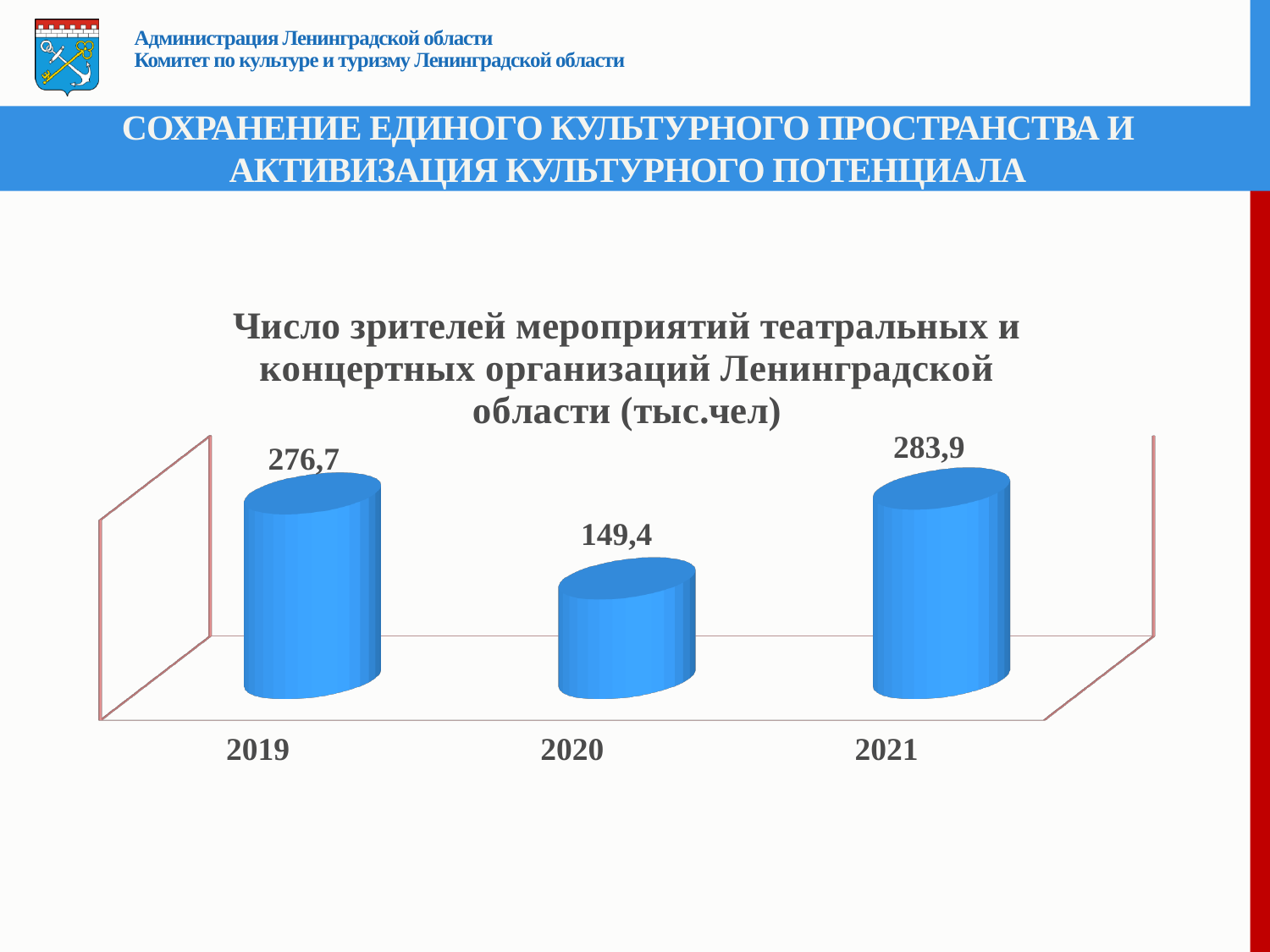
In what unit are the values on the chart expressed, according to the title? тыс.чел What is the difference between the values for 2021 and 2020? 134,5 What is the value for 2021? 283,9 What is the difference between the values for 2019 and 2020? 127,3 Which year has the highest number of spectators? 2021 Which year has the lowest number of spectators? 2020 Which is larger, the value for 2019 or the value for 2021? 2021 What kind of chart is shown on the slide? bar chart What is the value for 2019? 276,7 What is the value for 2020? 149,4 Does the value rise or fall from 2020 to 2021? rise How many years are shown on the chart? 3